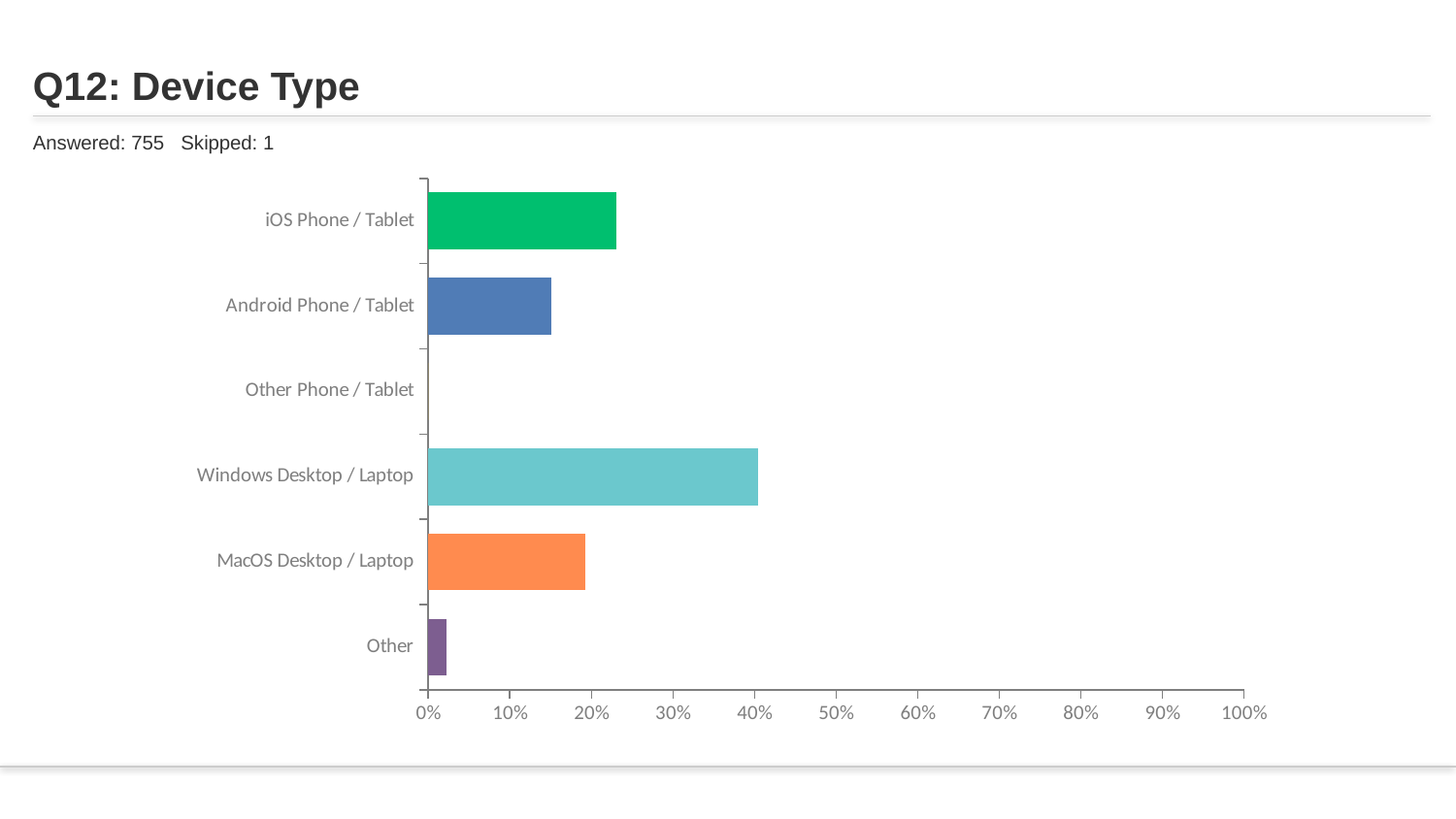
Is the value for Android Phone / Tablet greater or less than 20%? less How many device categories are shown in the chart? 6 Is the value for iOS Phone / Tablet greater or less than 20%? greater Which is larger, the value for Windows Desktop / Laptop or MacOS Desktop / Laptop? Windows Desktop / Laptop Which device category has the highest value? Windows Desktop / Laptop Is the value for Other greater or less than 10%? less How many respondents answered the question according to the slide? 755 Which device category has the lowest value? Other Phone / Tablet What is the title of the chart? Q12: Device Type What type of chart is shown on the slide? Bar chart Which is larger, the value for iOS Phone / Tablet or Android Phone / Tablet? iOS Phone / Tablet